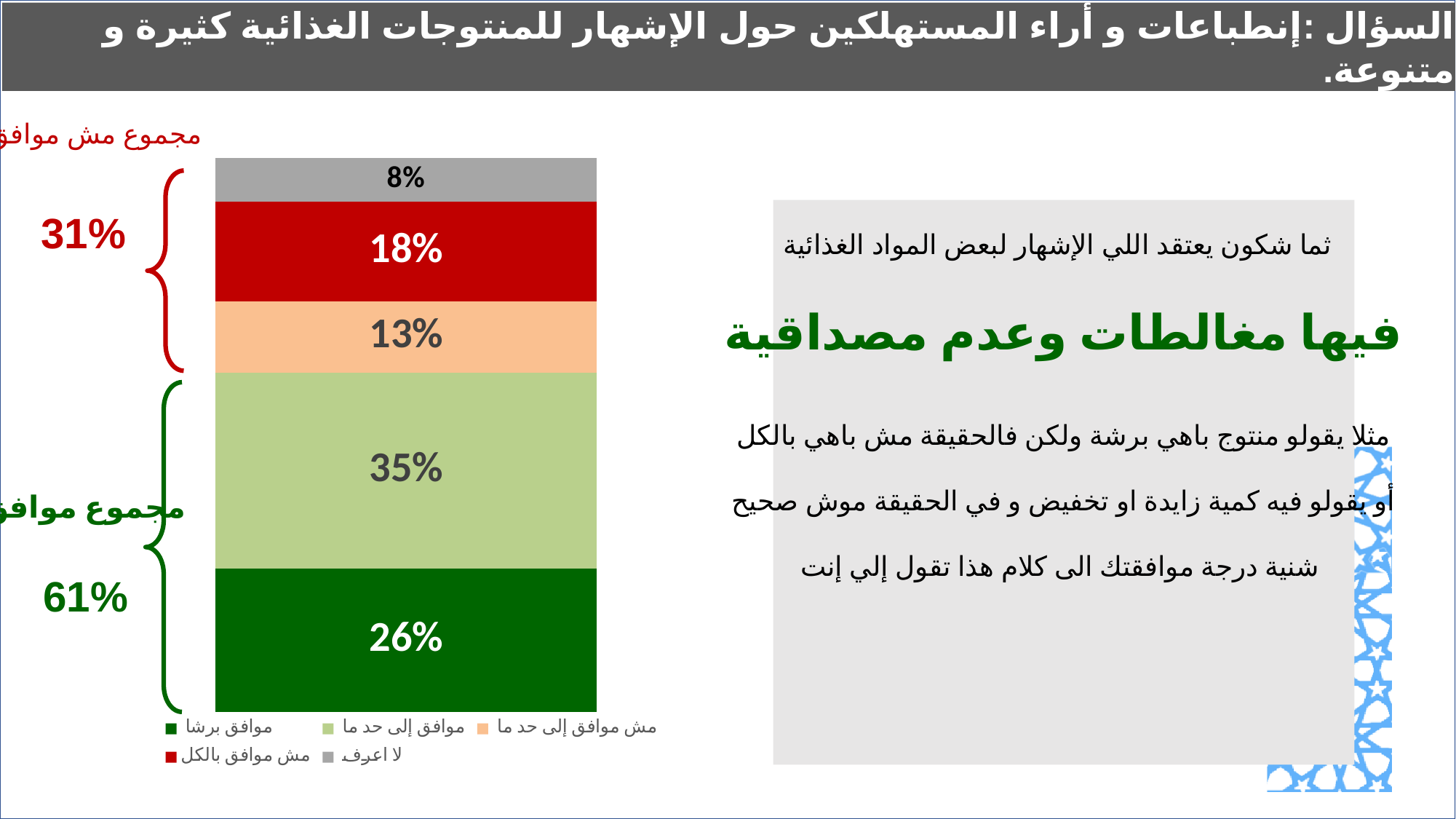
Which is larger: the share for "مش موافق بالكل" or the share for "مش موافق إلى حد ما"? مش موافق بالكل Which response category has the largest share in the stacked bar? موافق إلى حد ما What is the difference between the "موافق إلى حد ما" share and the "موافق برشا" share? 9% What percentage of respondents answered "مش موافق بالكل" (strongly disagree)? 18% What is the combined total of the two agree segments ("موافق برشا" and "موافق إلى حد ما")? 61% What percentage of respondents answered "موافق برشا" (strongly agree)? 26% What is the combined total of the two disagree segments ("مش موافق إلى حد ما" and "مش موافق بالكل")? 31% How many series does the legend list? 5 What kind of chart is shown on the slide? Stacked bar chart Which response category has the smallest share in the stacked bar? لا اعرف What percentage of respondents answered "موافق إلى حد ما" (somewhat agree)? 35% What percentage of respondents answered "لا اعرف" (don't know)? 8%